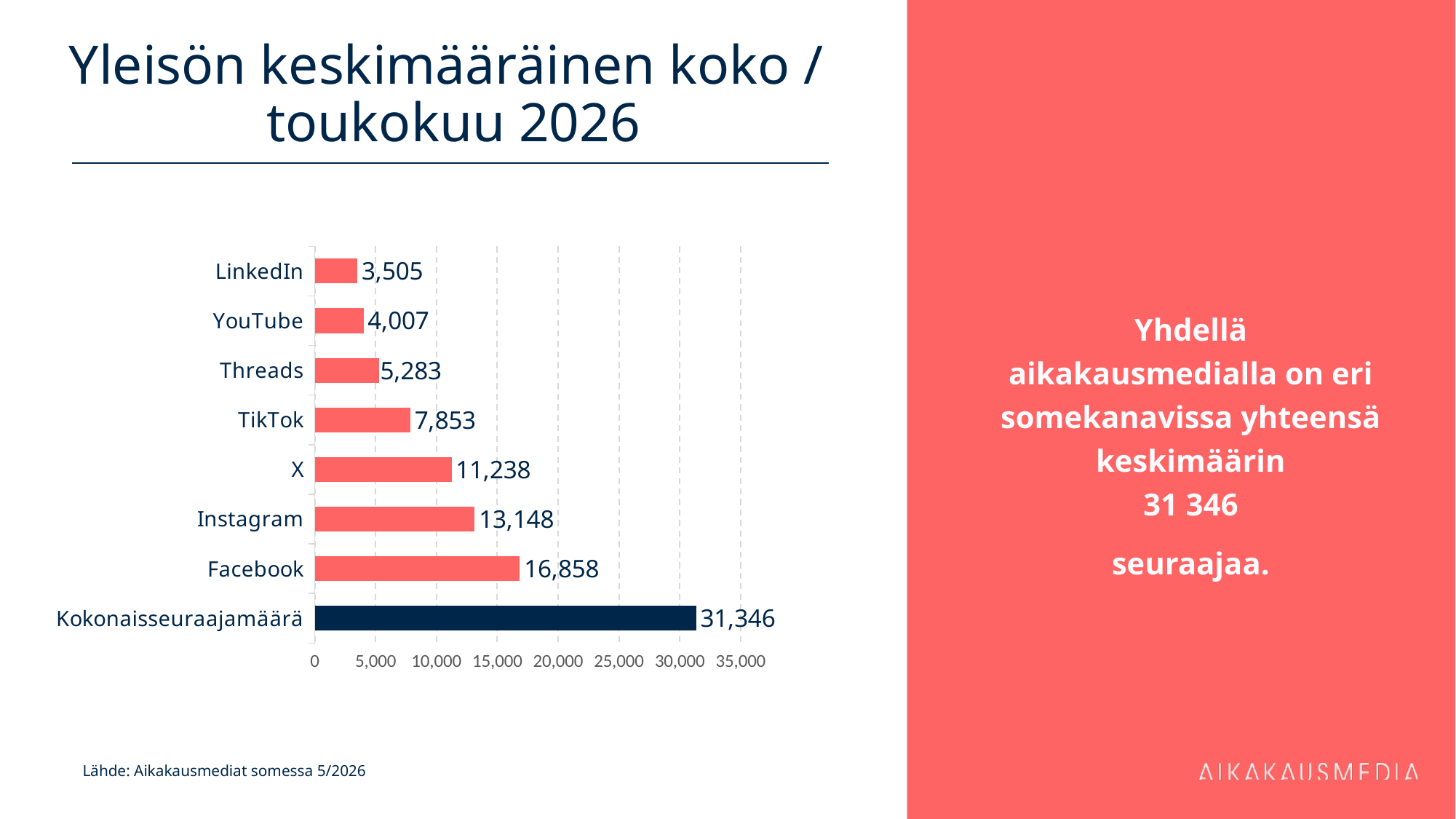
Which category has the highest value? Kokonaisseuraajamäärä What kind of chart is shown on the slide? Bar chart Which category has the lowest value? LinkedIn What is the value for Kokonaisseuraajamäärä? 31,346 What is the value for Facebook? 16,858 What is the difference between the values for Instagram and X? 1,910 How many categories are shown in the chart? 8 Which bar is shown in a different colour (dark navy) from the others? Kokonaisseuraajamäärä What is the value for TikTok? 7,853 Is the value for Facebook greater or less than 15,000? greater What is the difference between the values for Facebook and LinkedIn? 13,353 Which is larger, the value for YouTube or the value for Threads? Threads